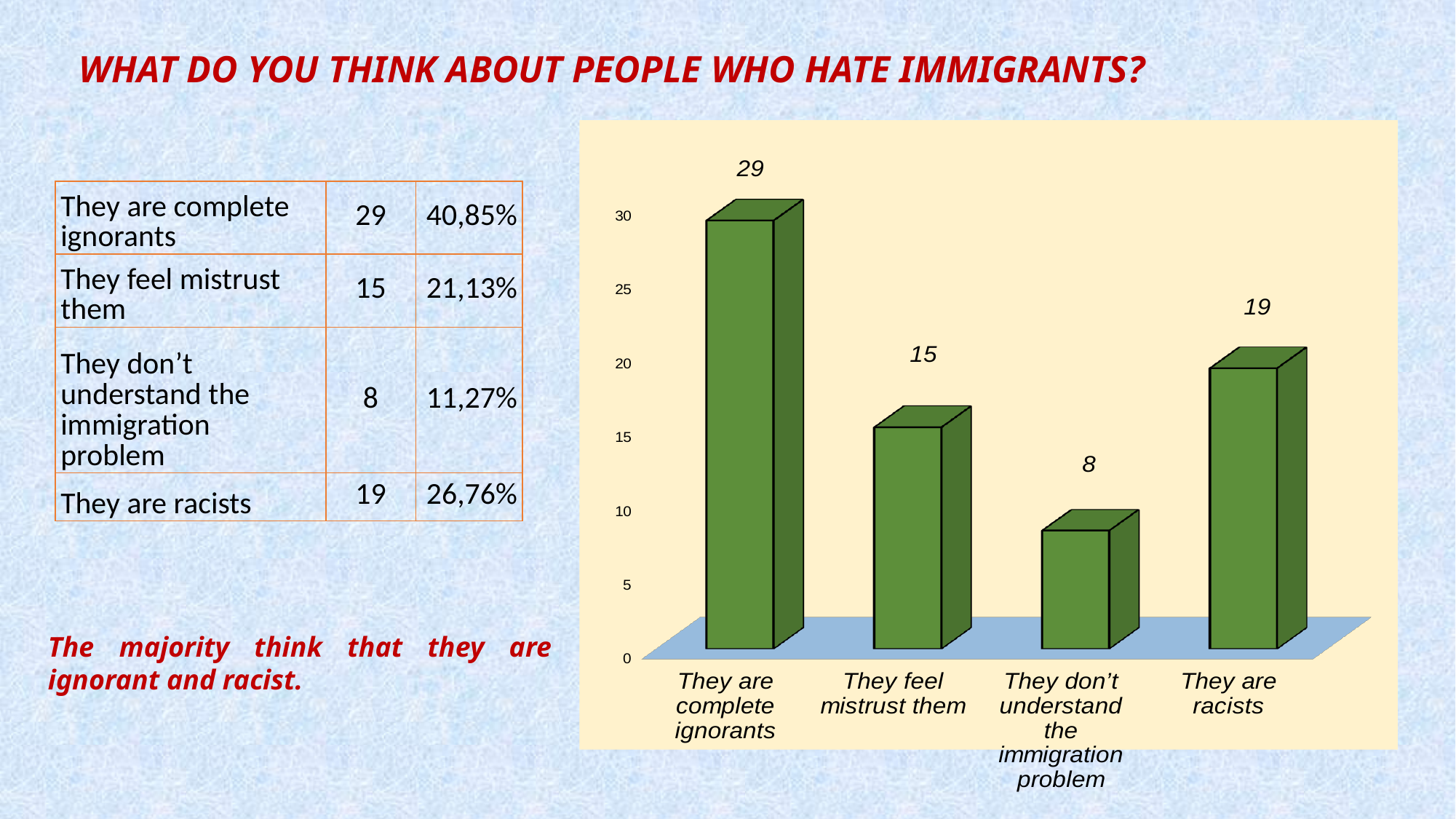
What is the difference between the values for 'They are complete ignorants' and 'They are racists'? 10 Which category has the highest value? They are complete ignorants What is the value for 'They don't understand the immigration problem'? 8 Which category has the lowest value? They don't understand the immigration problem What kind of chart is shown on the slide? Bar chart What is the value for 'They are racists'? 19 Which is larger, the value for 'They are racists' or the value for 'They feel mistrust them'? They are racists What is the value for 'They are complete ignorants'? 29 What is the difference between the values for 'They feel mistrust them' and 'They don't understand the immigration problem'? 7 What is the value for 'They feel mistrust them'? 15 How many categories are shown on the chart? 4 What colour are the bars in the chart? Green